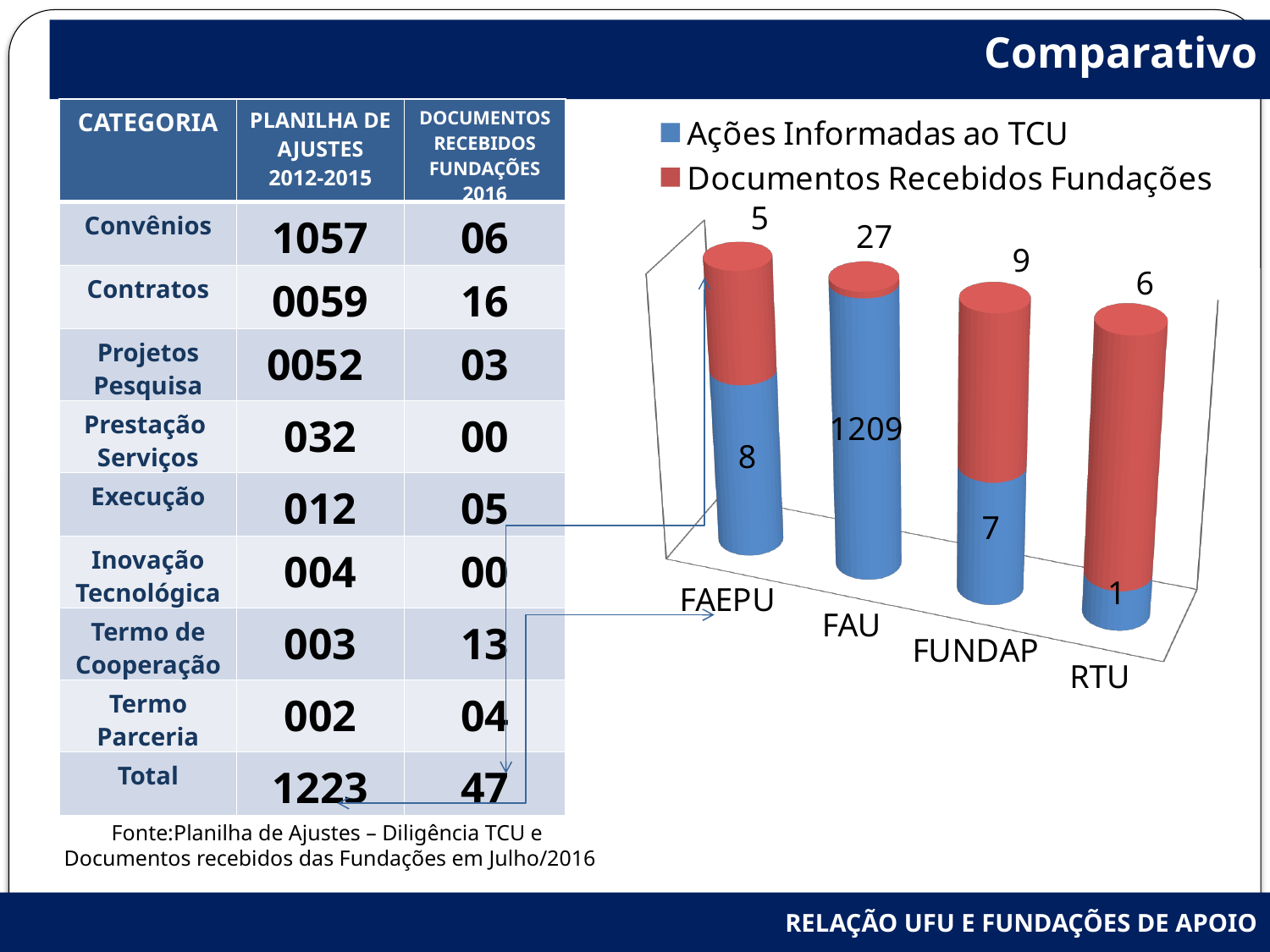
What is the total of the two series for FUNDAP? 16 What is the value of Ações Informadas ao TCU for FAU? 1209 Which is larger for FUNDAP: Ações Informadas ao TCU or Documentos Recebidos Fundações? Documentos Recebidos Fundações What is the value of Documentos Recebidos Fundações for FUNDAP? 9 What is the value of Ações Informadas ao TCU for RTU? 1 How many categories are shown on the x axis of the chart? 4 What is the value of Documentos Recebidos Fundações for FAEPU? 5 What is the difference between Documentos Recebidos Fundações for FAU and for RTU? 21 How many series does the chart legend list? 2 What kind of chart is shown on the slide? Stacked bar chart Which category has the highest value for Ações Informadas ao TCU? FAU Which category has the lowest value for Documentos Recebidos Fundações? FAEPU